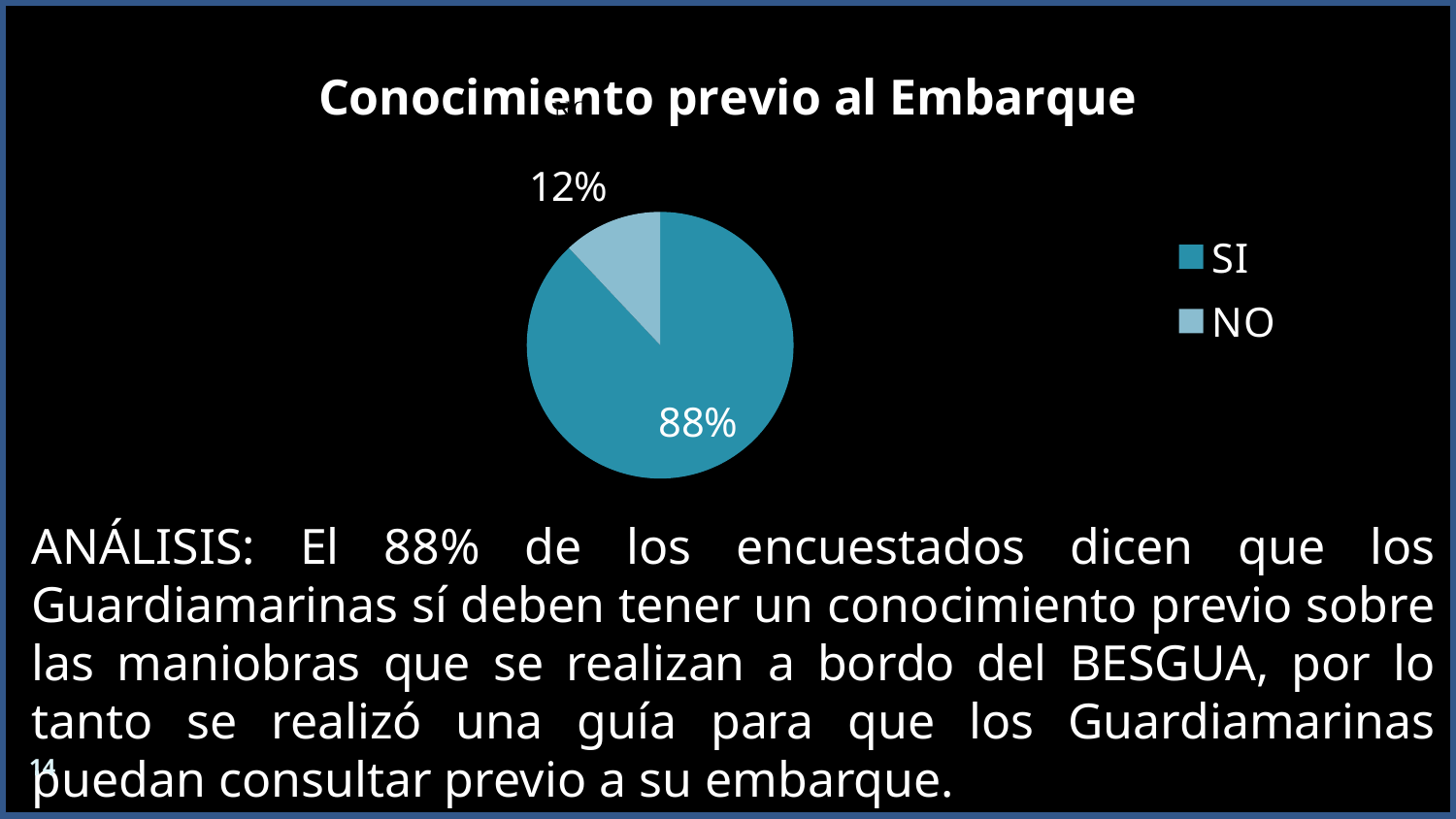
Which legend entry is shown in the lighter blue colour? NO How many entries does the legend list? 2 Which category has the largest share of the pie? SI What share of the pie does the NO slice represent? 12% What percentage of the pie is labelled NO? 12% Which category has the smallest share of the pie? NO Which slice is larger, SI or NO? SI What kind of chart is shown on the slide? pie chart What percentage of the pie is labelled SI? 88% What is the title of the chart? Conocimiento previo al Embarque How many categories does the pie chart have? 2 What is the difference in percentage points between the SI and NO slices? 76